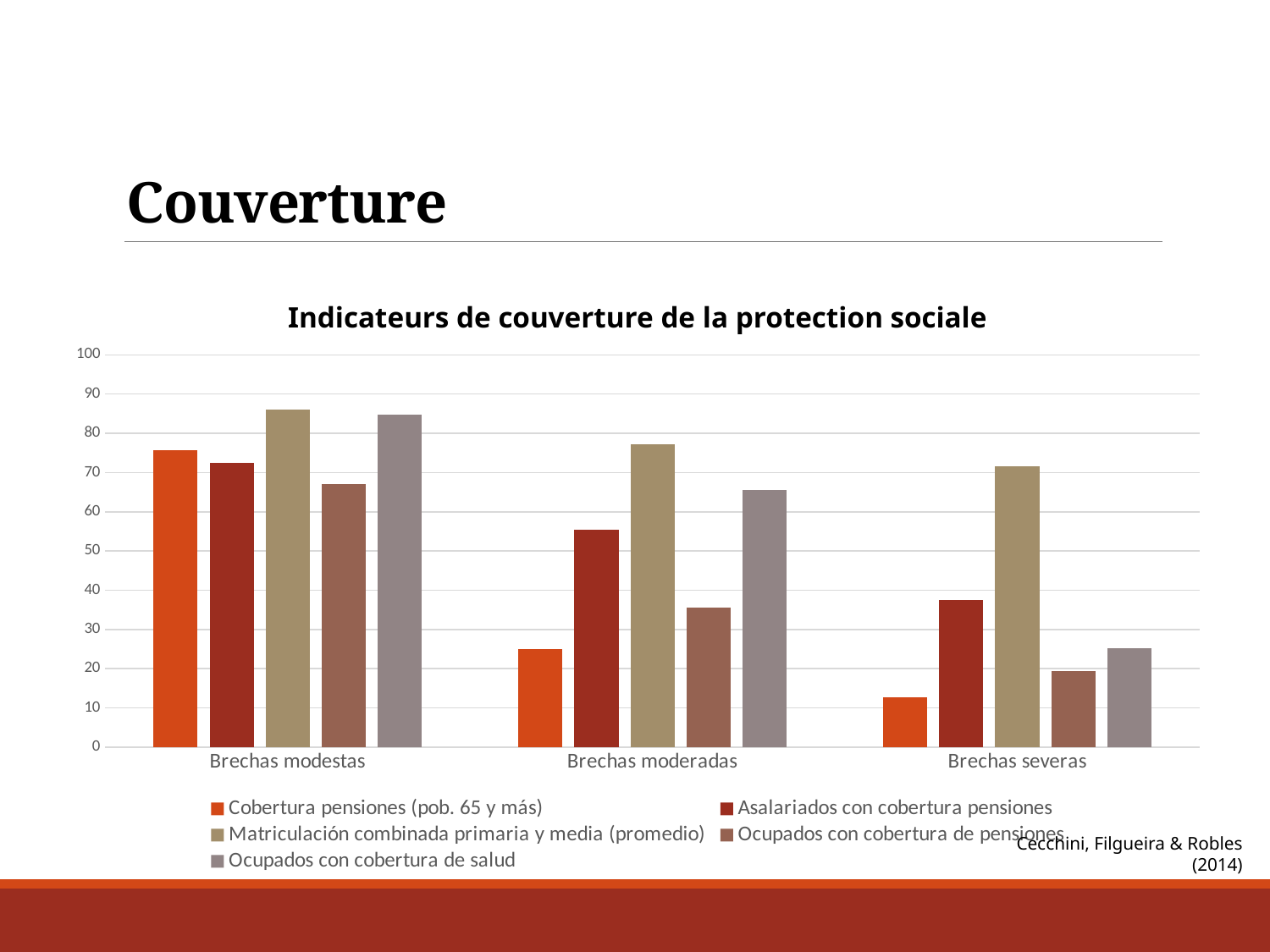
Is the value for Matriculación combinada primaria y media (promedio) in Brechas modestas greater or less than 80? greater Within the Brechas moderadas category, which series has the lowest value? Cobertura pensiones (pob. 65 y más) How many categories are shown on the x axis? 3 Which is larger for Asalariados con cobertura pensiones: Brechas moderadas or Brechas severas? Brechas moderadas What source is cited for the chart? Cecchini, Filgueira & Robles (2014) What kind of chart is shown on the slide? bar chart Is the value for Cobertura pensiones (pob. 65 y más) in Brechas severas greater or less than 20? less What is the title of the chart? Indicateurs de couverture de la protection sociale How many series does the legend list? 5 Do the values for Cobertura pensiones (pob. 65 y más) rise or fall from Brechas modestas to Brechas severas? fall Within the Brechas severas category, which series has the highest value? Matriculación combinada primaria y media (promedio) Is the value for Ocupados con cobertura de salud in Brechas moderadas greater or less than 60? greater